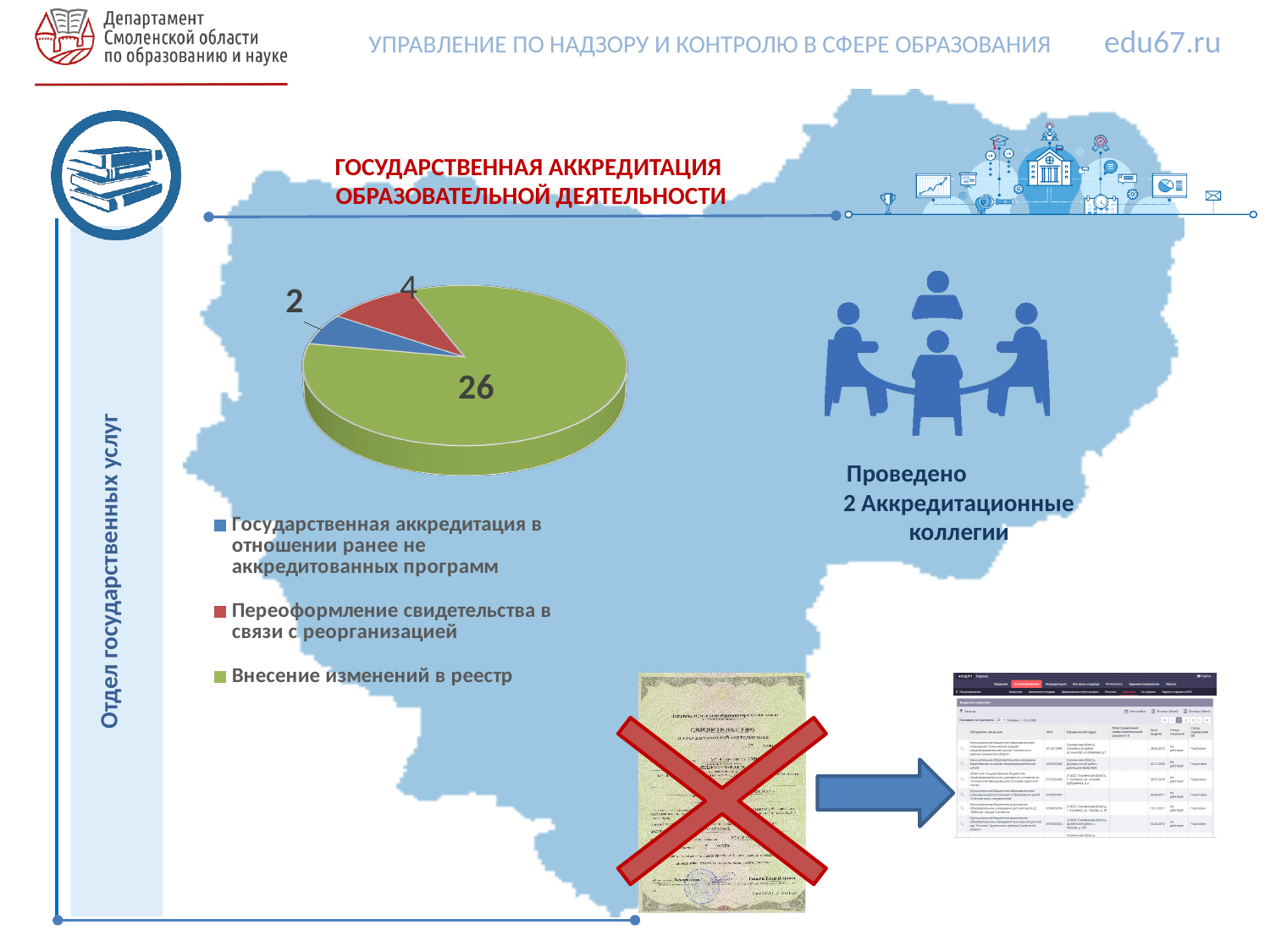
What kind of chart is shown on the slide? pie chart How many categories does the pie chart have? 3 What is the value for "Внесение изменений в реестр"? 26 Which is larger: the value for "Переоформление свидетельства в связи с реорганизацией" or the value for "Государственная аккредитация в отношении ранее не аккредитованных программ"? Переоформление свидетельства в связи с реорганизацией What is the value for "Переоформление свидетельства в связи с реорганизацией"? 4 Which category has the smallest slice of the pie? Государственная аккредитация в отношении ранее не аккредитованных программ What share of the pie does "Переоформление свидетельства в связи с реорганизацией" represent? 12.5% What colour is the slice for "Внесение изменений в реестр"? green Which category has the largest slice of the pie? Внесение изменений в реестр What is the difference between the values for "Внесение изменений в реестр" and "Переоформление свидетельства в связи с реорганизацией"? 22 What is the value for "Государственная аккредитация в отношении ранее не аккредитованных программ"? 2 What is the total of all slices in the pie chart? 32